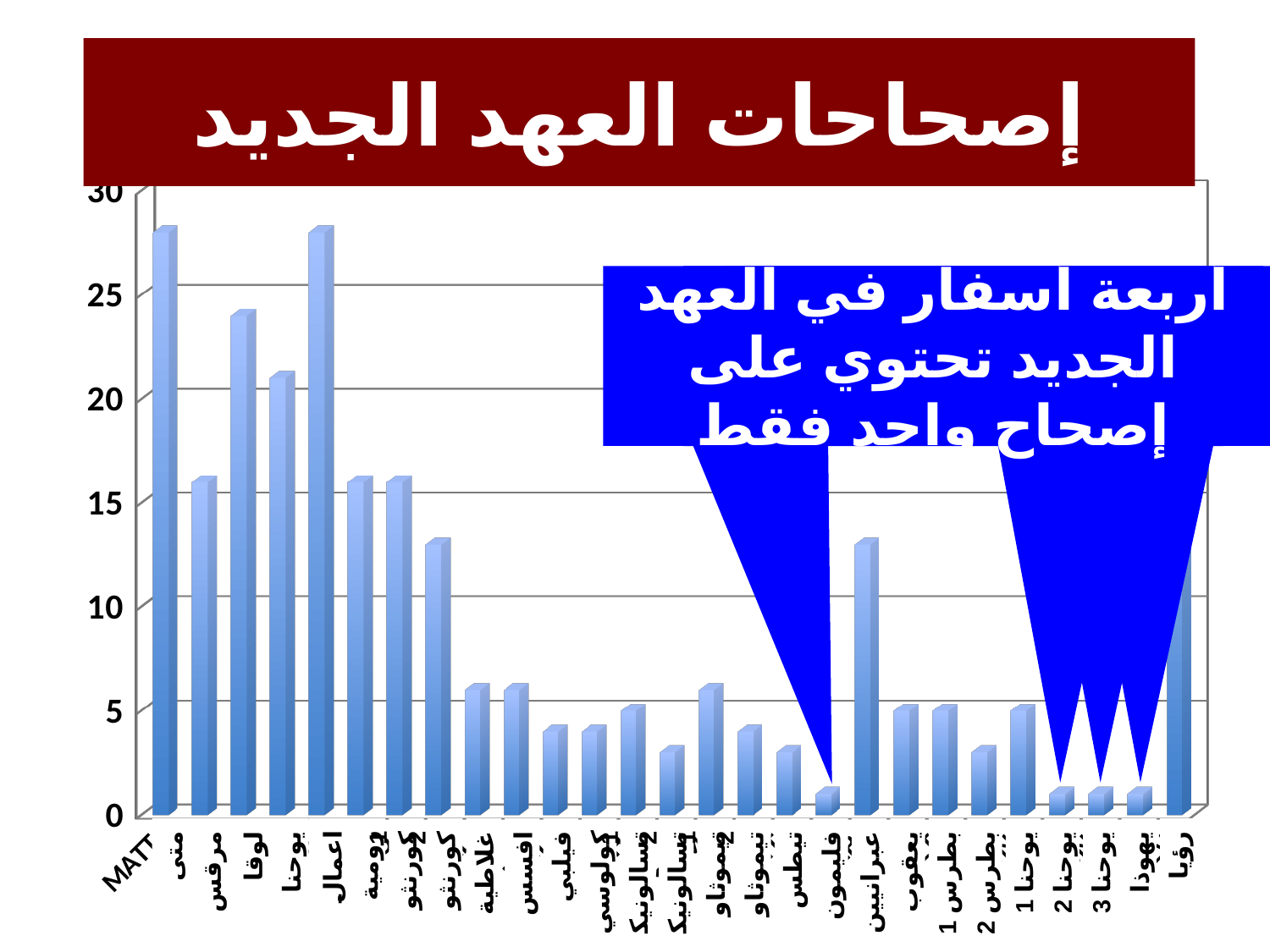
Is the value of the bar above the label MATT greater or less than 25? greater Is the value of the bar above the label مرقس greater or less than 20? less Is the value of the bar above the label فليمون greater or less than 5? less Which bar is taller, the one above the label عبرانيين or the one above the label يعقوب? عبرانيين What kind of chart is shown on the slide? bar chart What is the highest value shown on the vertical axis? 30 What is the title of the chart on the slide? إصحاحات العهد الجديد Which bar is taller, the one above the label مرقس or the one above the label لوقا? لوقا